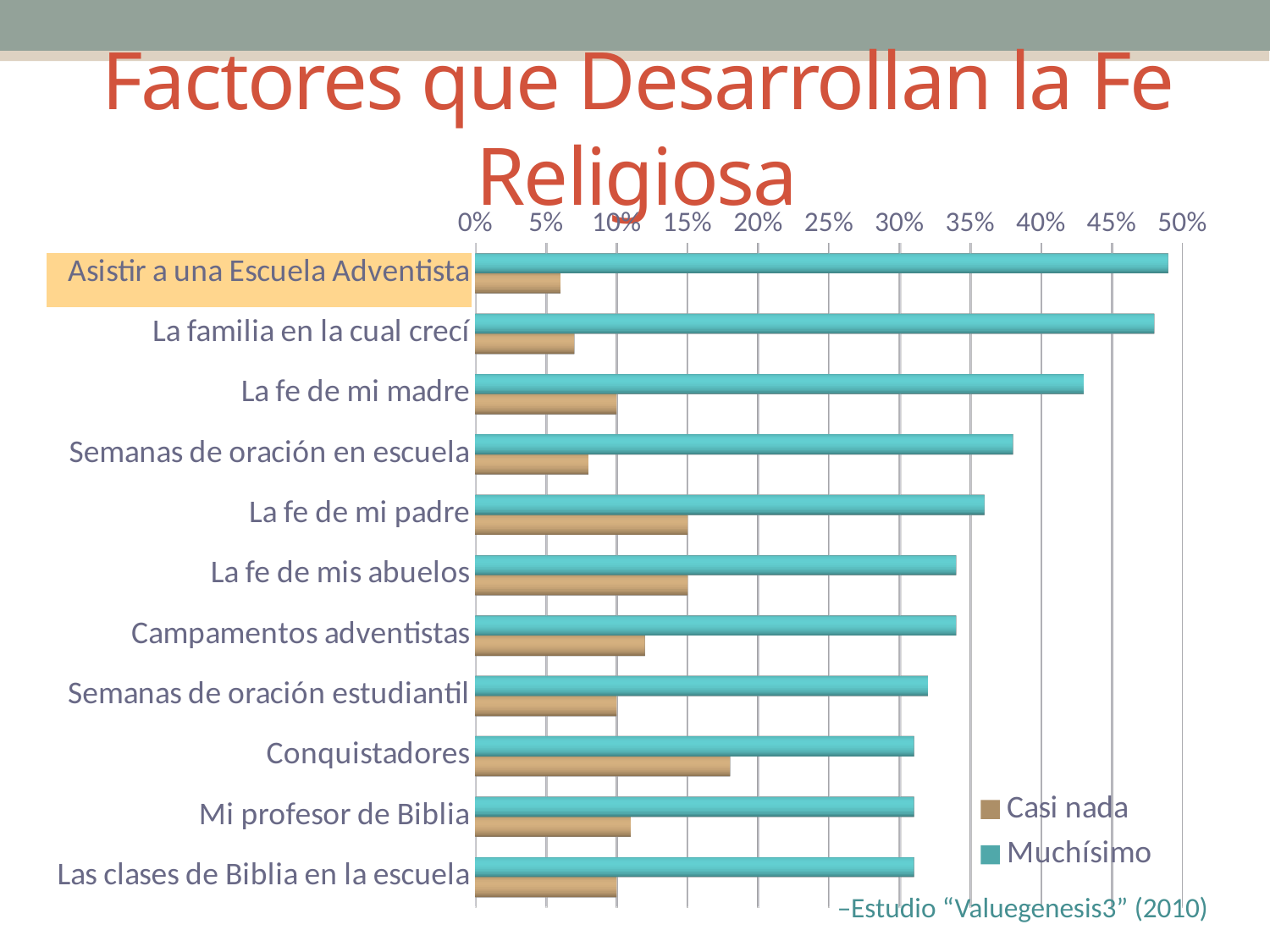
What source is cited below the chart? Estudio "Valuegenesis3" (2010) Which is larger: the 'Casi nada' value for Conquistadores or for Mi profesor de Biblia? Conquistadores Which category has the highest 'Casi nada' value? Conquistadores Which is larger: the 'Muchísimo' value for La fe de mi madre or for La fe de mi padre? La fe de mi madre Is the 'Casi nada' value for Asistir a una Escuela Adventista greater or less than 10%? less What kind of chart is shown on the slide? Bar chart Is the 'Muchísimo' value for Conquistadores greater or less than 35%? less How many categories (factors) are plotted on the chart? 11 Is the 'Muchísimo' value for Semanas de oración en escuela greater or less than 35%? greater How many series does the legend list? 2